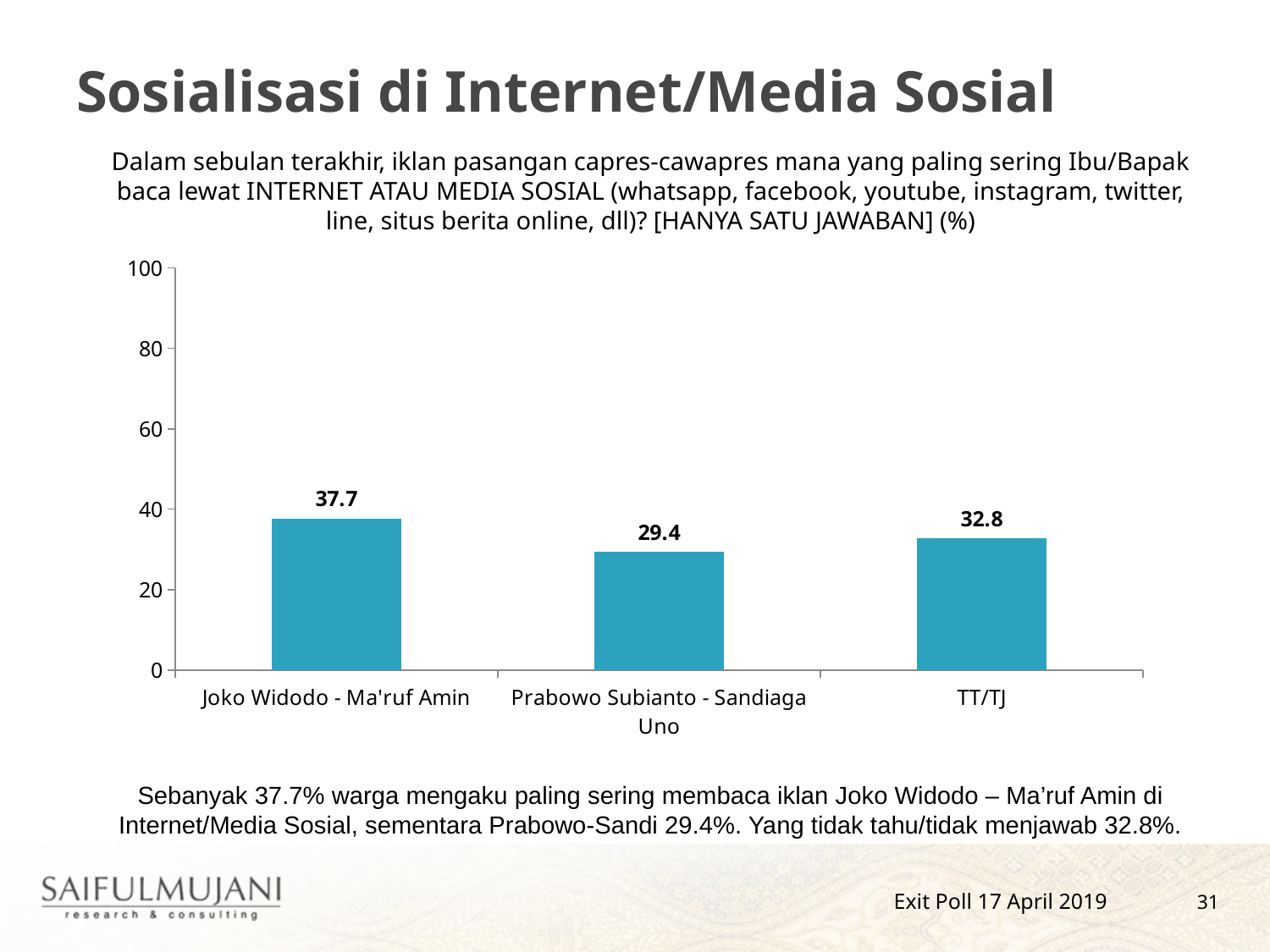
Which is larger, the value for TT/TJ or the value for Prabowo Subianto - Sandiaga Uno? TT/TJ What is the value for Joko Widodo - Ma'ruf Amin? 37.7 What is the difference between the values for TT/TJ and Prabowo Subianto - Sandiaga Uno? 3.4 Is the value for Joko Widodo - Ma'ruf Amin greater or less than 40? less What is the value for TT/TJ? 32.8 What is the value for Prabowo Subianto - Sandiaga Uno? 29.4 What is the difference between the values for Joko Widodo - Ma'ruf Amin and Prabowo Subianto - Sandiaga Uno? 8.3 What is the maximum value shown on the y axis? 100 Which category has the lowest value? Prabowo Subianto - Sandiaga Uno Which category has the highest value? Joko Widodo - Ma'ruf Amin How many categories are shown on the x axis? 3 What kind of chart is shown on the slide? bar chart